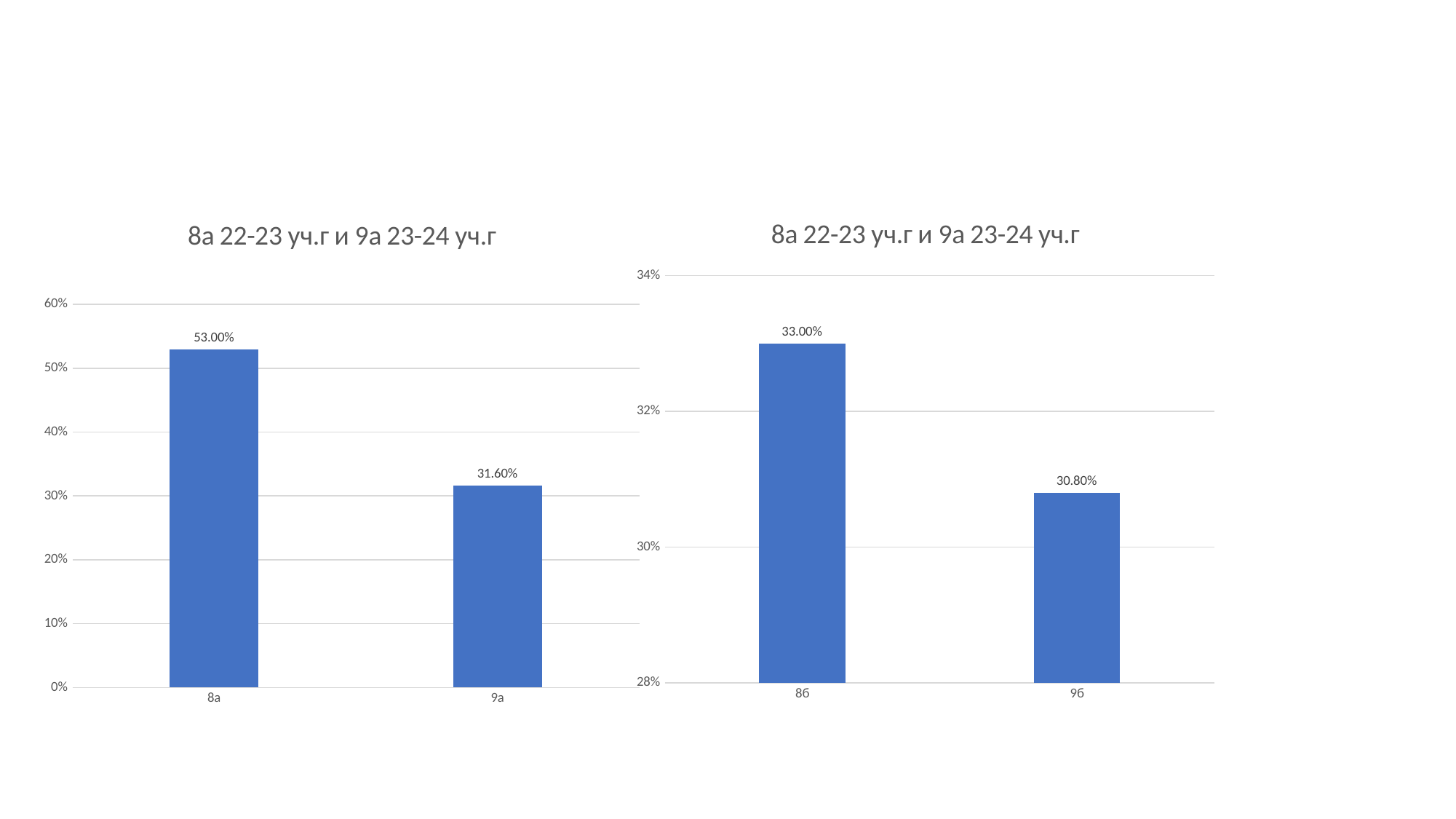
What kind of chart is the right chart? bar chart In the right chart, what is the difference between the values for 8б and 9б? 2.20% In the right chart, which category has the lowest value? 9б In the left chart, what is the value for 8а? 53.00% In the left chart, what is the value for 9а? 31.60% In the left chart, what is the difference between the values for 8а and 9а? 21.40% How many categories are shown in the left chart? 2 In the left chart, is the value for 9а greater or less than 40%? less In the right chart, what is the value for 8б? 33.00% In the left chart, which category has the highest value? 8а In the right chart, which is larger, the value for 8б or the value for 9б? 8б In the right chart, what is the value for 9б? 30.80%